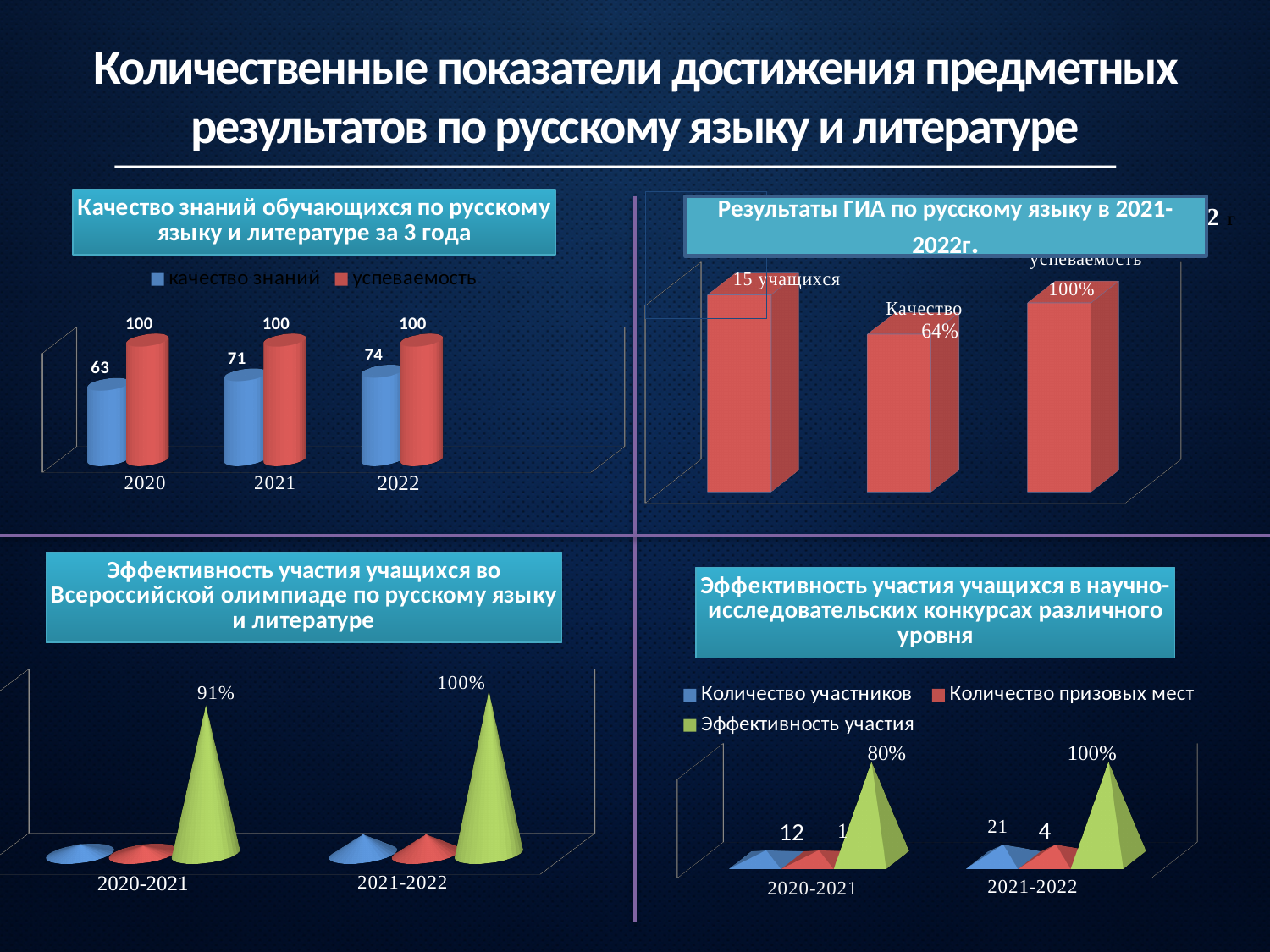
In the chart 'Качество знаний обучающихся по русскому языку и литературе за 3 года', does 'качество знаний' rise or fall from 2020 to 2022? rise In the chart 'Качество знаний обучающихся по русскому языку и литературе за 3 года', which year has the highest 'качество знаний'? 2022 In the chart 'Качество знаний обучающихся по русскому языку и литературе за 3 года', what is the value of 'качество знаний' for 2020? 63 In the chart 'Эффективность участия учащихся в научно-исследовательских конкурсах различного уровня', what is 'Количество участников' for 2021-2022? 21 In the chart 'Результаты ГИА по русскому языку в 2021-2022г.', what is the value for 'Качество'? 64% In the chart 'Результаты ГИА по русскому языку в 2021-2022г.', what is the value for 'успеваемость'? 100% In the chart 'Качество знаний обучающихся по русскому языку и литературе за 3 года', what is the value of 'качество знаний' for 2022? 74 In the chart 'Эффективность участия учащихся во Всероссийской олимпиаде по русскому языку и литературе', what is the value for 2020-2021? 91% What kind of chart is 'Качество знаний обучающихся по русскому языку и литературе за 3 года'? bar chart In the chart 'Качество знаний обучающихся по русскому языку и литературе за 3 года', what is the difference between 'качество знаний' in 2021 and 2020? 8 In the chart 'Эффективность участия учащихся в научно-исследовательских конкурсах различного уровня', what is 'Эффективность участия' for 2020-2021? 80% How many series does the legend of the chart 'Качество знаний обучающихся по русскому языку и литературе за 3 года' list? 2